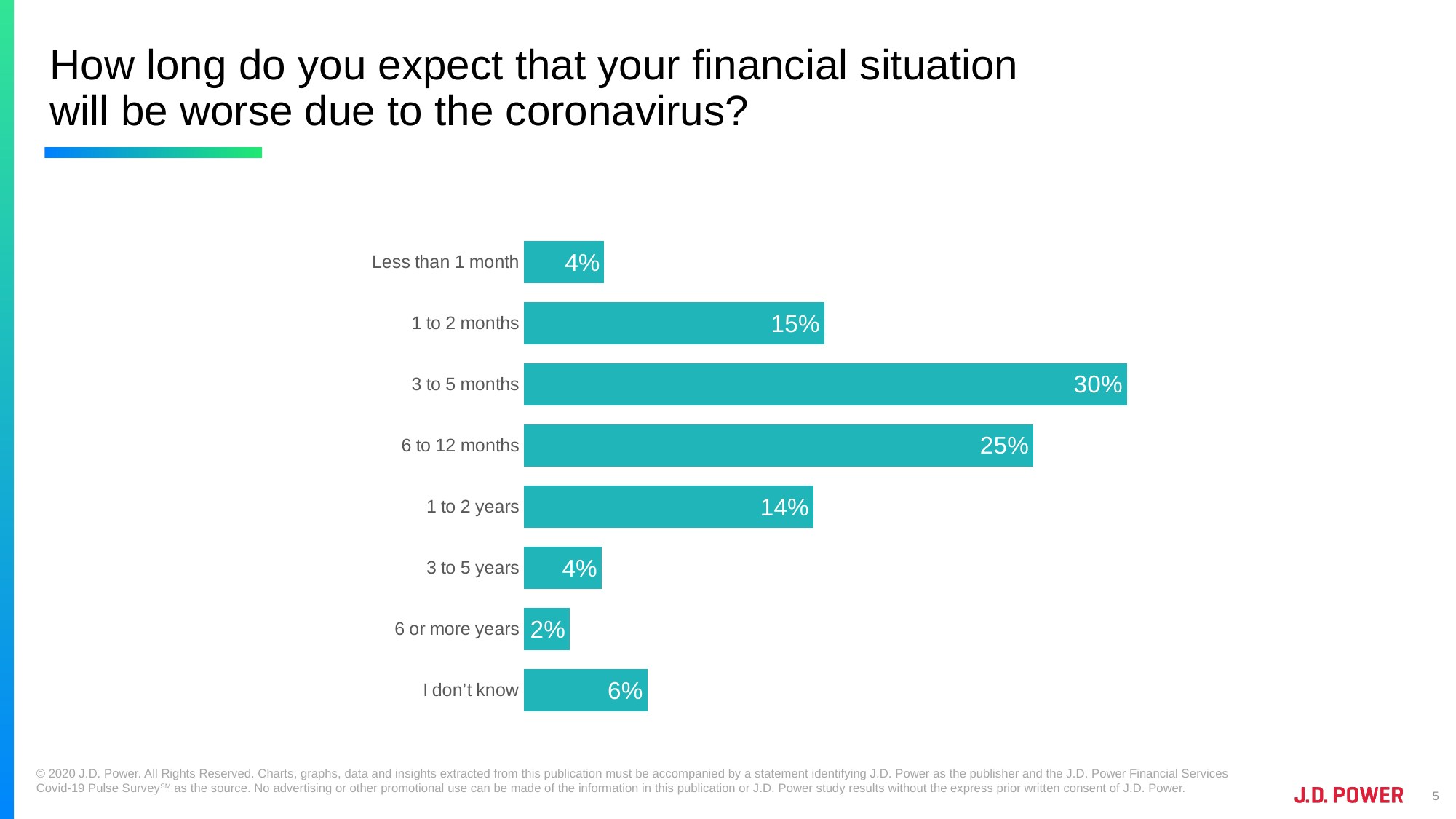
What is the difference between the values for '1 to 2 months' and '1 to 2 years'? 1% Which category has the lowest value? 6 or more years Which category has the highest value? 3 to 5 months Which is larger, the value for '1 to 2 months' or the value for 'I don't know'? 1 to 2 months What percentage of respondents expect their financial situation to be worse for 3 to 5 months? 30% What colour are the bars in the chart? Teal How many categories are shown in the chart? 8 What is the value for '1 to 2 years'? 14% What percentage of respondents answered 'I don't know'? 6% What is the value for the '6 to 12 months' category? 25% What kind of chart is shown on the slide? Bar chart What is the difference between the values for '3 to 5 months' and '6 to 12 months'? 5%